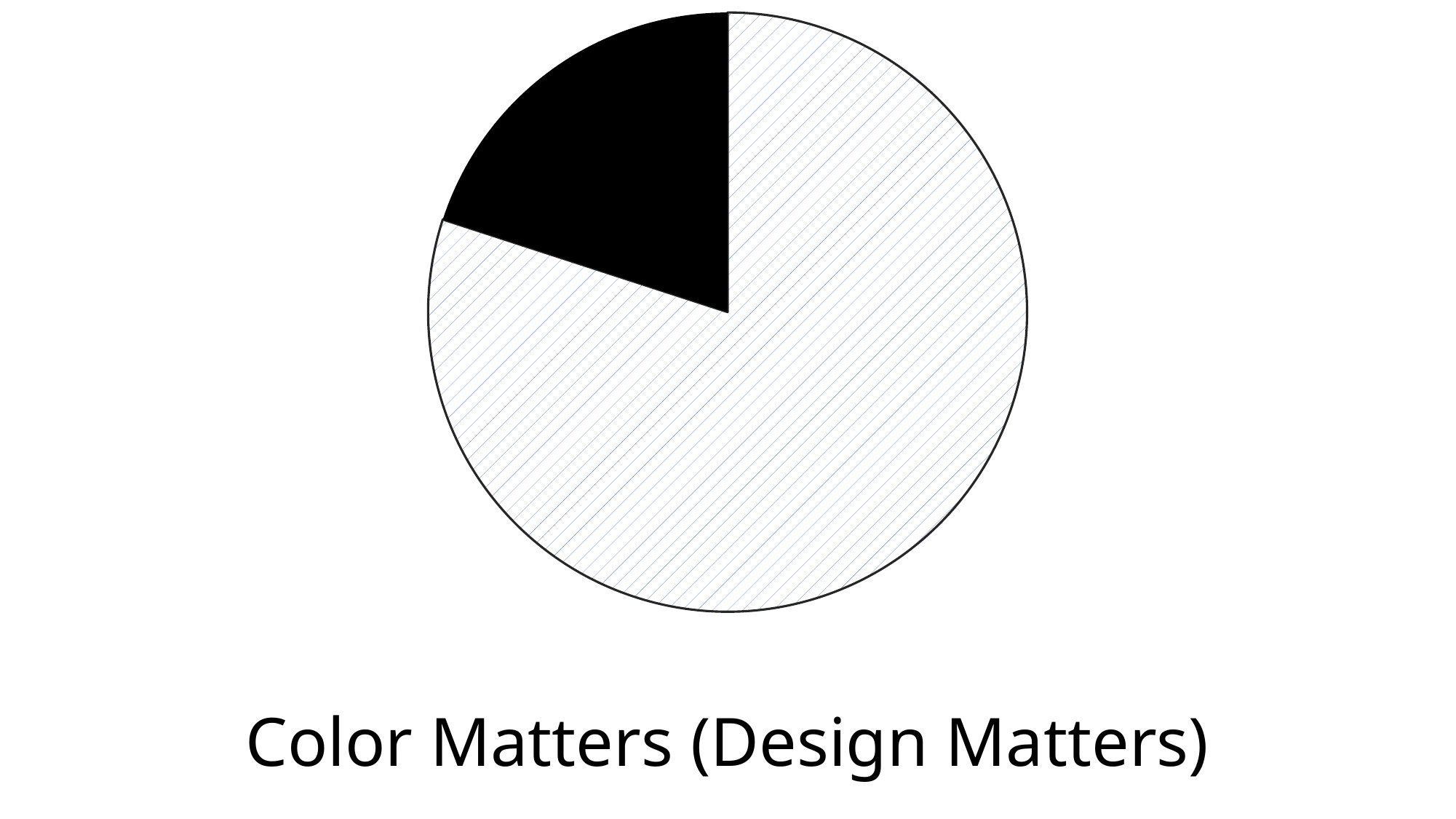
What text appears below the pie chart? Color Matters (Design Matters) What colour is the smaller slice of the pie chart? black What kind of chart is shown on the slide? pie chart Which slice of the pie chart is the smallest? the black slice How many slices does the pie chart have? 2 Which slice of the pie chart is the largest? the hatched slice Which slice of the pie chart is larger, the black slice or the hatched slice? the hatched slice